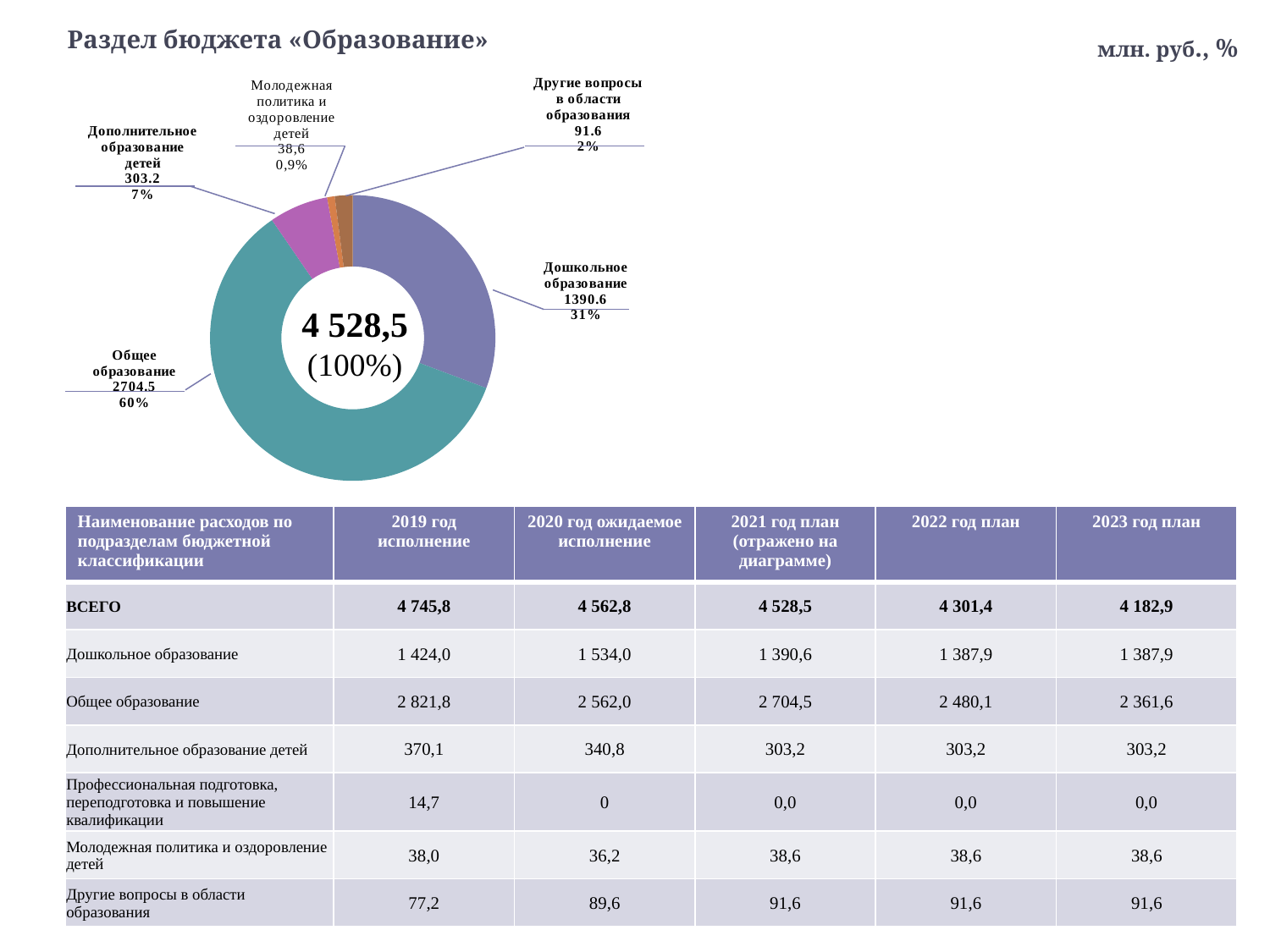
What share of the chart does Дошкольное образование represent? 31% How many slices does the chart have? 5 What is the value shown for Дошкольное образование on the chart? 1390.6 What is the value shown for Другие вопросы в области образования on the chart? 91.6 What is the difference between the values for Общее образование and Дошкольное образование in the chart? 1313.9 Which category has the largest slice in the chart? Общее образование What is the value shown for Дополнительное образование детей on the chart? 303.2 What total value is shown in the centre of the chart? 4 528,5 Which category has the smallest slice in the chart? Молодежная политика и оздоровление детей What share of the chart does Молодежная политика и оздоровление детей represent? 0,9% What is the value shown for Общее образование on the chart? 2704.5 What kind of chart is shown on the slide? Pie (donut) chart